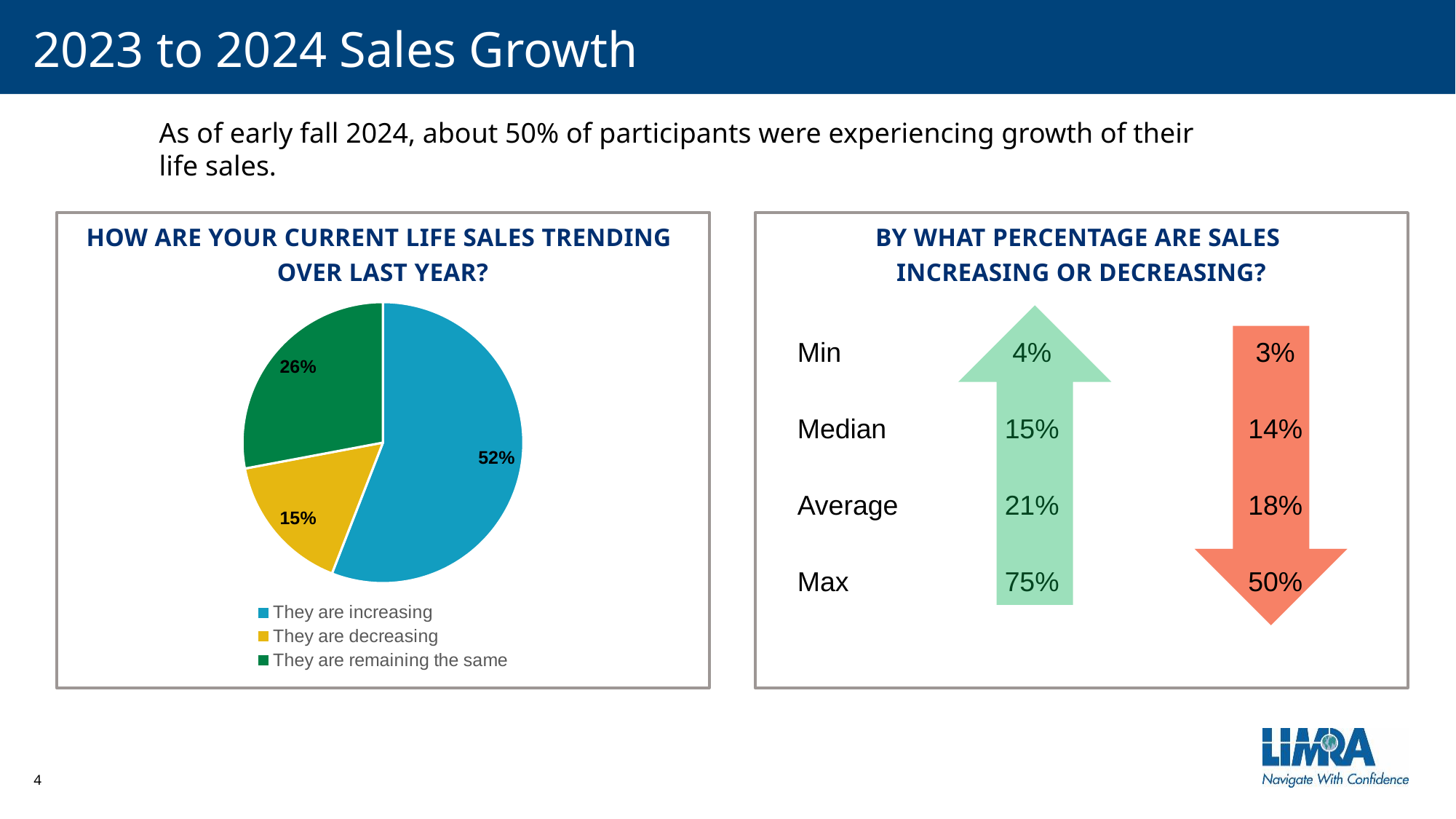
What type of chart is shown on the left side of the slide? Pie chart In the pie chart on the left, what is the difference in percentage points between 'They are increasing' and 'They are remaining the same'? 26 In the pie chart on the left, which response has the smallest share? They are decreasing How many slices does the pie chart on the left have? 3 In the pie chart on the left, which is larger: the share for 'They are remaining the same' or the share for 'They are decreasing'? They are remaining the same In the graphic 'By what percentage are sales increasing or decreasing?', what is the maximum percentage by which sales are decreasing? 50% In the pie chart on the left, what colour is the slice for 'They are increasing'? Blue In the graphic 'By what percentage are sales increasing or decreasing?', what is the median percentage by which sales are increasing? 15% In the pie chart on the left, which response has the largest share? They are increasing In the pie chart on the left, what percentage of participants said their life sales are remaining the same? 26% In the pie chart 'How are your current life sales trending over last year?', what share of participants said their sales are increasing? 52% In the pie chart on the left, what percentage of participants said their life sales are decreasing? 15%